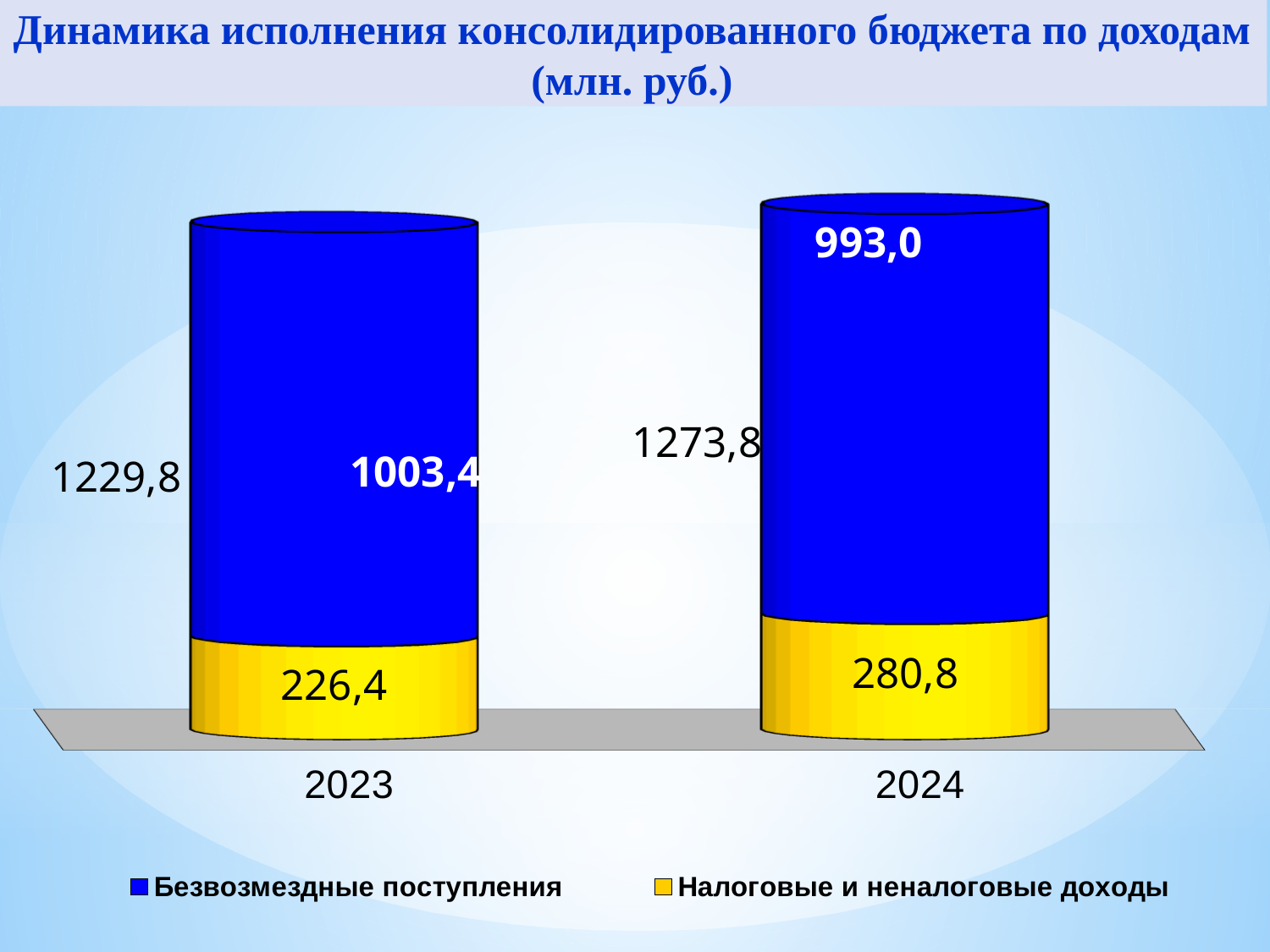
What is the value of Налоговые и неналоговые доходы for 2023? 226,4 What is the value of Налоговые и неналоговые доходы for 2024? 280,8 What is the value of Безвозмездные поступления for 2024? 993,0 How many series does the legend list? 2 What is the total of the stacked bar for 2024? 1273,8 What is the difference between the Налоговые и неналоговые доходы values for 2024 and 2023? 54,4 What kind of chart is shown on the slide? Stacked bar chart What is the value of Безвозмездные поступления for 2023? 1003,4 Which year has the lower value for Безвозмездные поступления? 2024 Which year has the higher value for Налоговые и неналоговые доходы? 2024 How many categories (years) are shown on the x axis? 2 What is the total of the stacked bar for 2023? 1229,8